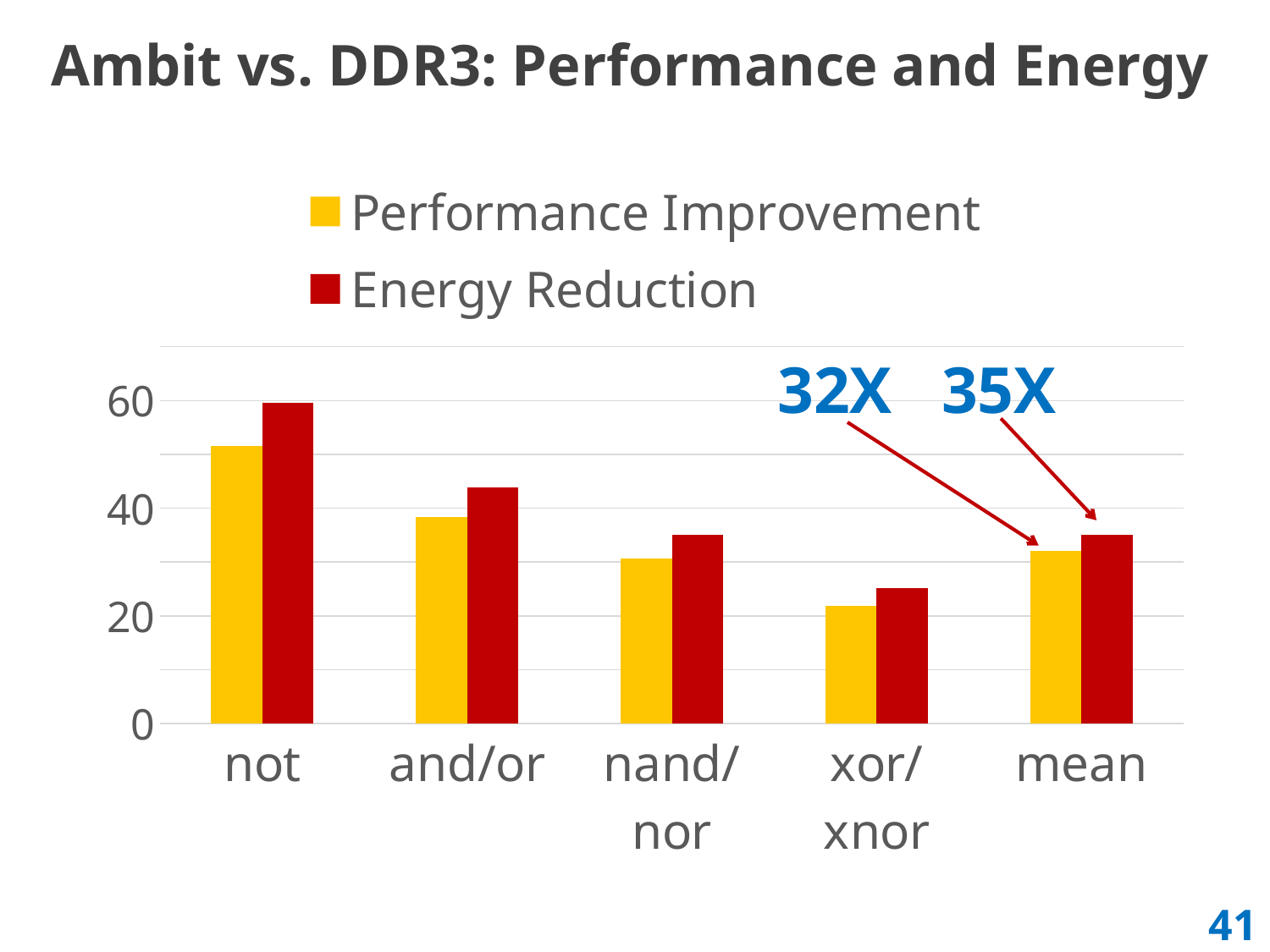
Is the Performance Improvement value for not greater or less than 40? greater What is the Energy Reduction value for the mean category? 35X Is the Energy Reduction value for xor/xnor greater or less than 40? less What kind of chart is shown on the slide? bar chart Which category has the highest Energy Reduction? not How many series does the legend list? 2 Which colour represents Energy Reduction in the legend? red What is the difference between the Energy Reduction and Performance Improvement values for the mean category? 3X What is the Performance Improvement value for the mean category? 32X Which category has the lowest Performance Improvement? xor/xnor For the not category, which is larger: Performance Improvement or Energy Reduction? Energy Reduction How many categories are shown on the x axis? 5